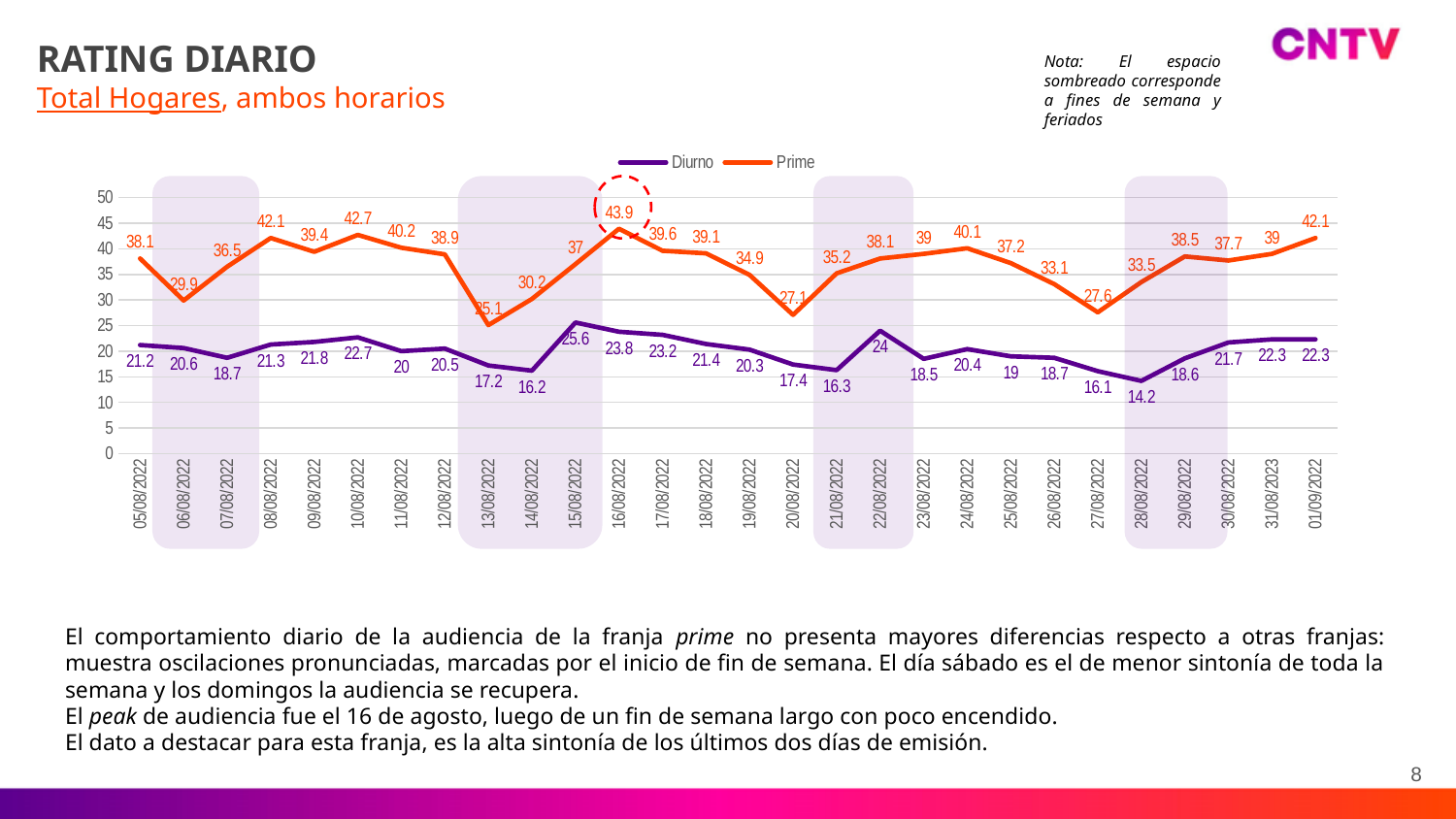
What is the Diurno value on 28/08/2022? 14.2 How many series does the legend list? 2 What is the Prime value on 16/08/2022? 43.9 On which date does the Diurno series reach its highest value? 15/08/2022 What are the names of the two series in the legend? Diurno and Prime What is the difference between the Prime and Diurno values on 16/08/2022? 20.1 Which is larger, the Prime value on 05/08/2022 or the Prime value on 06/08/2022? 05/08/2022 What type of chart is shown on the slide? line chart What is the Prime value on 13/08/2022? 25.1 How many dates are plotted on the x axis? 28 On which date does the Diurno series reach its lowest value? 28/08/2022 On which date does the Prime series reach its highest value? 16/08/2022